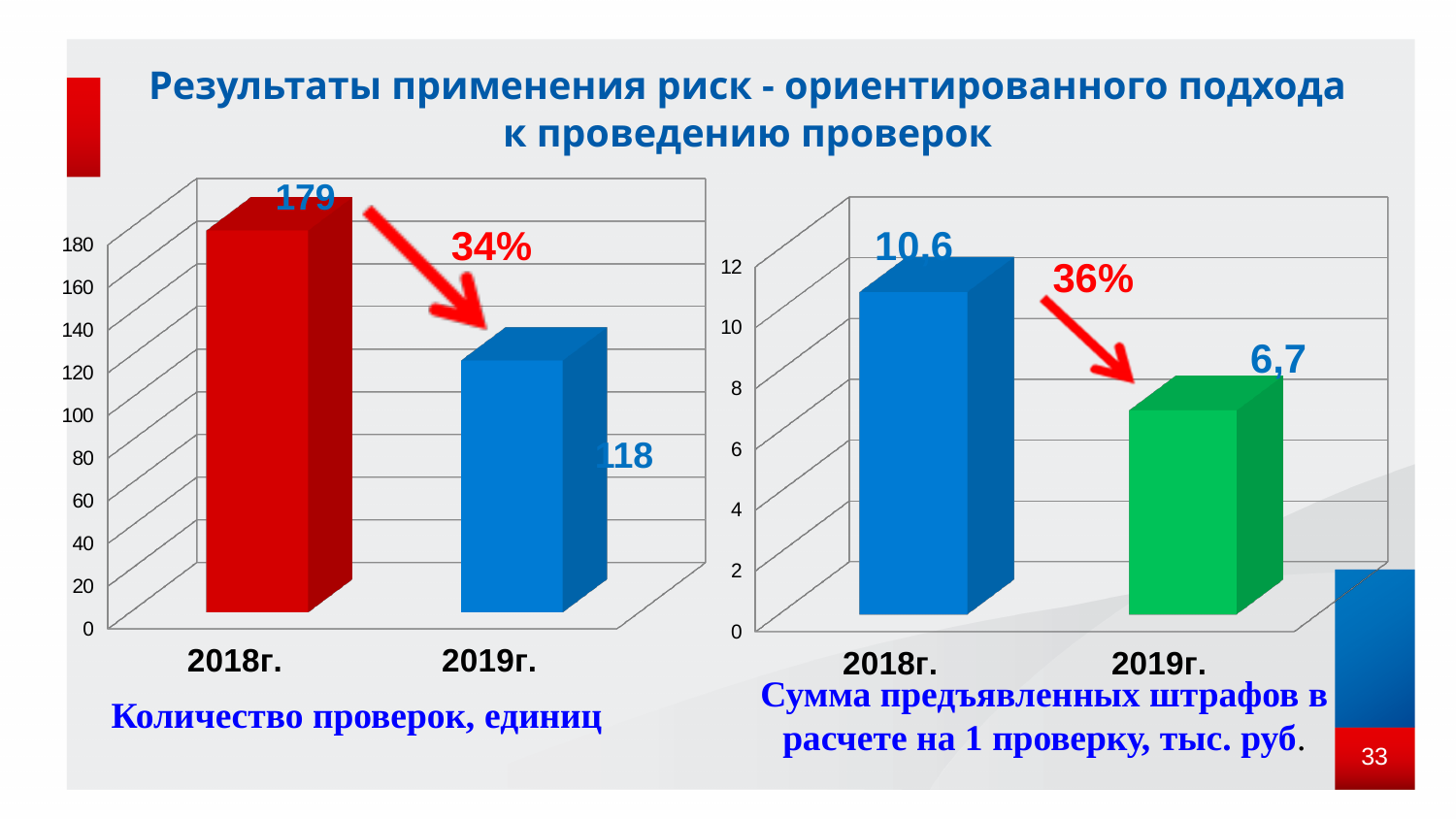
In the chart 'Сумма предъявленных штрафов в расчете на 1 проверку, тыс. руб.', is the value for 2019г. greater or less than 8? less In the chart 'Количество проверок, единиц', what is the value for 2018г.? 179 In the chart 'Сумма предъявленных штрафов в расчете на 1 проверку, тыс. руб.', which year has the lower value? 2019г. In the chart 'Количество проверок, единиц', do the values rise or fall from 2018г. to 2019г.? fall In the chart 'Количество проверок, единиц', which year has the higher value? 2018г. In the chart 'Сумма предъявленных штрафов в расчете на 1 проверку, тыс. руб.', what is the value for 2018г.? 10.6 In the chart 'Количество проверок, единиц', what is the value for 2019г.? 118 What kind of chart is 'Сумма предъявленных штрафов в расчете на 1 проверку, тыс. руб.'? bar chart In the chart 'Количество проверок, единиц', what percentage decrease is annotated next to the arrow? 34% In the chart 'Количество проверок, единиц', what is the difference between the 2018г. and 2019г. values? 61 How many categories are shown in the chart 'Количество проверок, единиц'? 2 In the chart 'Сумма предъявленных штрафов в расчете на 1 проверку, тыс. руб.', what is the value for 2019г.? 6,7